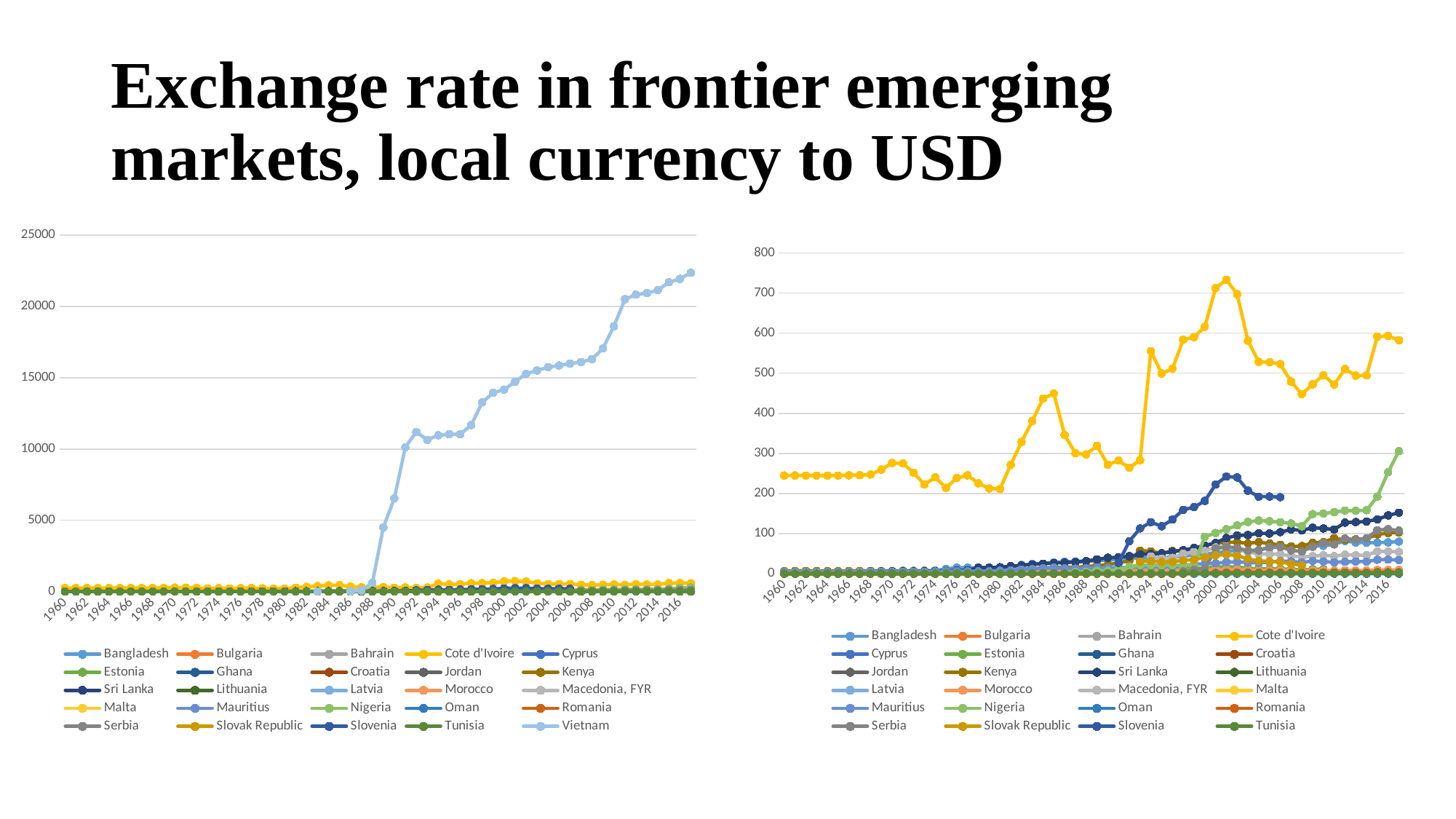
On the right chart, is the value for Cote d'Ivoire in 1960 greater or less than 300? less On the left chart, does the Vietnam series generally rise or fall from 1960 to 2016? rise On the left chart, is the value for Vietnam in 2016 greater or less than 20000? greater How many series does the legend of the left chart list? 25 On the right chart, is the value for Cote d'Ivoire in 2000 greater or less than 600? greater How many series does the legend of the right chart list? 24 Which series appears in the legend of the left chart but not in the legend of the right chart? Vietnam What kind of chart is the left chart on the slide? line chart On the right chart, which is larger in 2016, the value for Cote d'Ivoire or the value for Ghana? Cote d'Ivoire On the right chart, which series reaches the highest values? Cote d'Ivoire On the left chart, which series reaches the highest values? Vietnam What is the highest value shown on the y axis of the right chart? 800